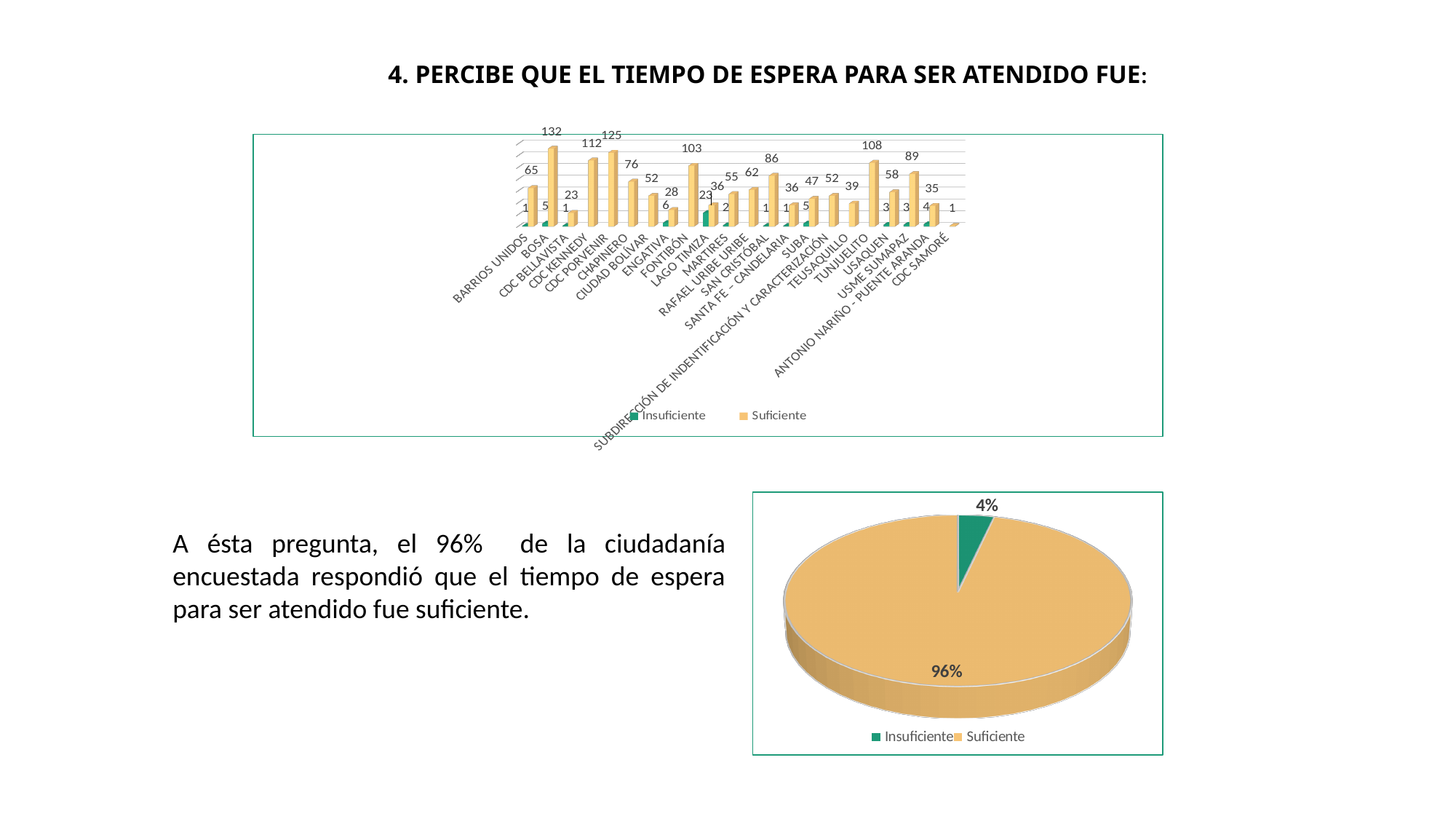
In the bar chart, what is the Suficiente value for BOSA? 132 What kind of chart is the top chart on the slide? Bar chart In the bar chart, which category has the highest Suficiente value? BOSA In the pie chart, what share does Insuficiente have? 4% How many series does the legend of the bar chart list? 2 In the pie chart, what share does Suficiente have? 96% In the bar chart, what is the Insuficiente value for LAGO TIMIZA? 23 In the bar chart, what is the Suficiente value for TUNJUELITO? 108 In the bar chart, which is larger: the Suficiente value for CDC KENNEDY or for FONTIBÓN? CDC KENNEDY What kind of chart is the bottom chart on the slide? Pie chart In the bar chart, what is the Suficiente value for CDC PORVENIR? 125 In the bar chart, what is the difference between the Suficiente values for BOSA and CDC PORVENIR? 7